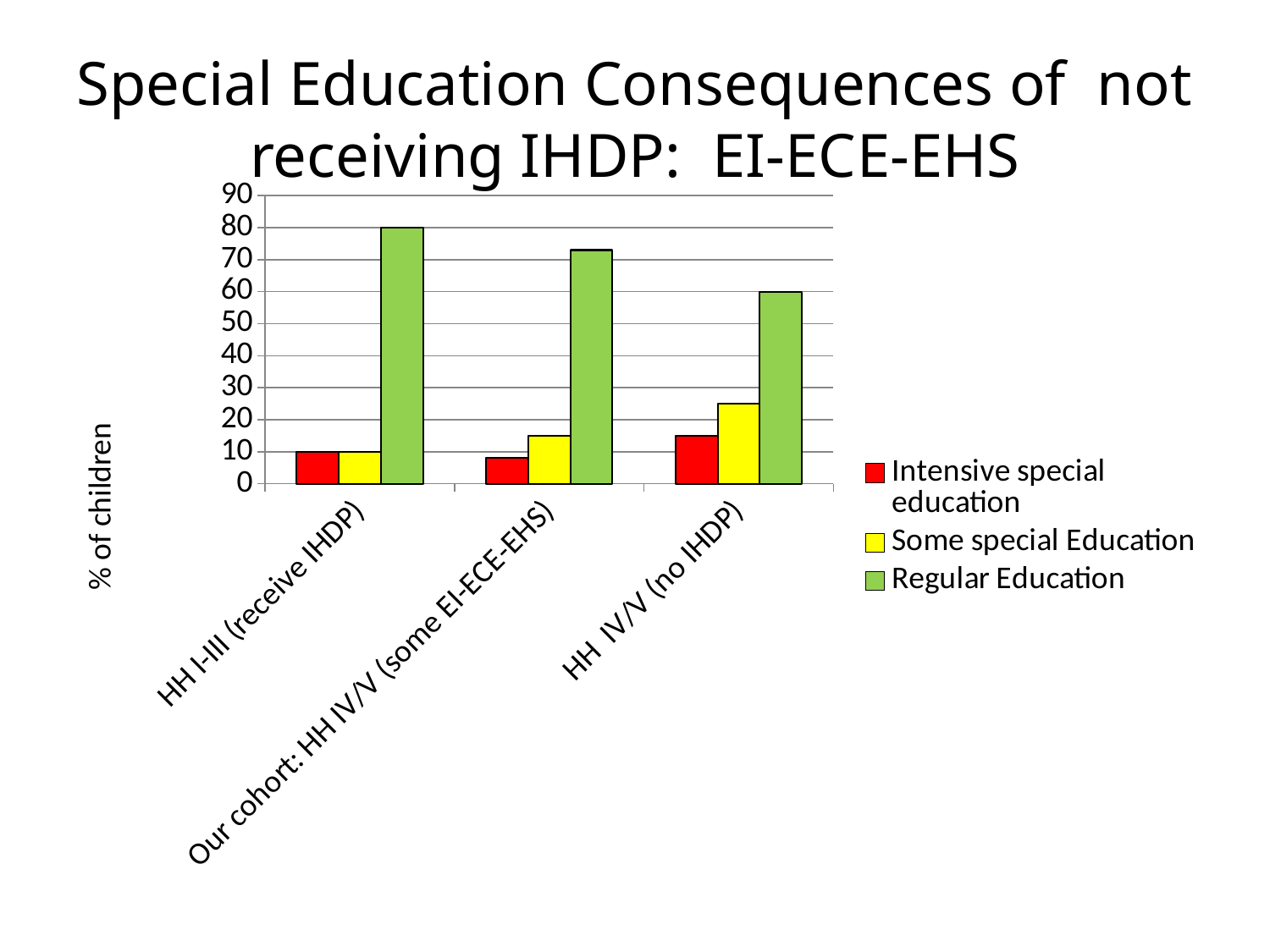
How many categories are shown on the x axis? 3 What type of chart is shown on the slide? bar chart What is the Regular Education value for HH IV/V (no IHDP)? 60 Which category has the highest Regular Education value? HH I-III (receive IHDP) What is the Regular Education value for HH I-III (receive IHDP)? 80 Is the Intensive special education value for Our cohort: HH IV/V (some EI-ECE-EHS) greater or less than 10? less What is the Intensive special education value for HH I-III (receive IHDP)? 10 Is the Regular Education value for Our cohort: HH IV/V (some EI-ECE-EHS) greater or less than 70? greater Does the Regular Education value rise or fall from HH I-III (receive IHDP) to HH IV/V (no IHDP)? fall How many series does the legend list? 3 Is the Some special Education value for HH IV/V (no IHDP) greater or less than 20? greater Which category has the lowest Regular Education value? HH IV/V (no IHDP)